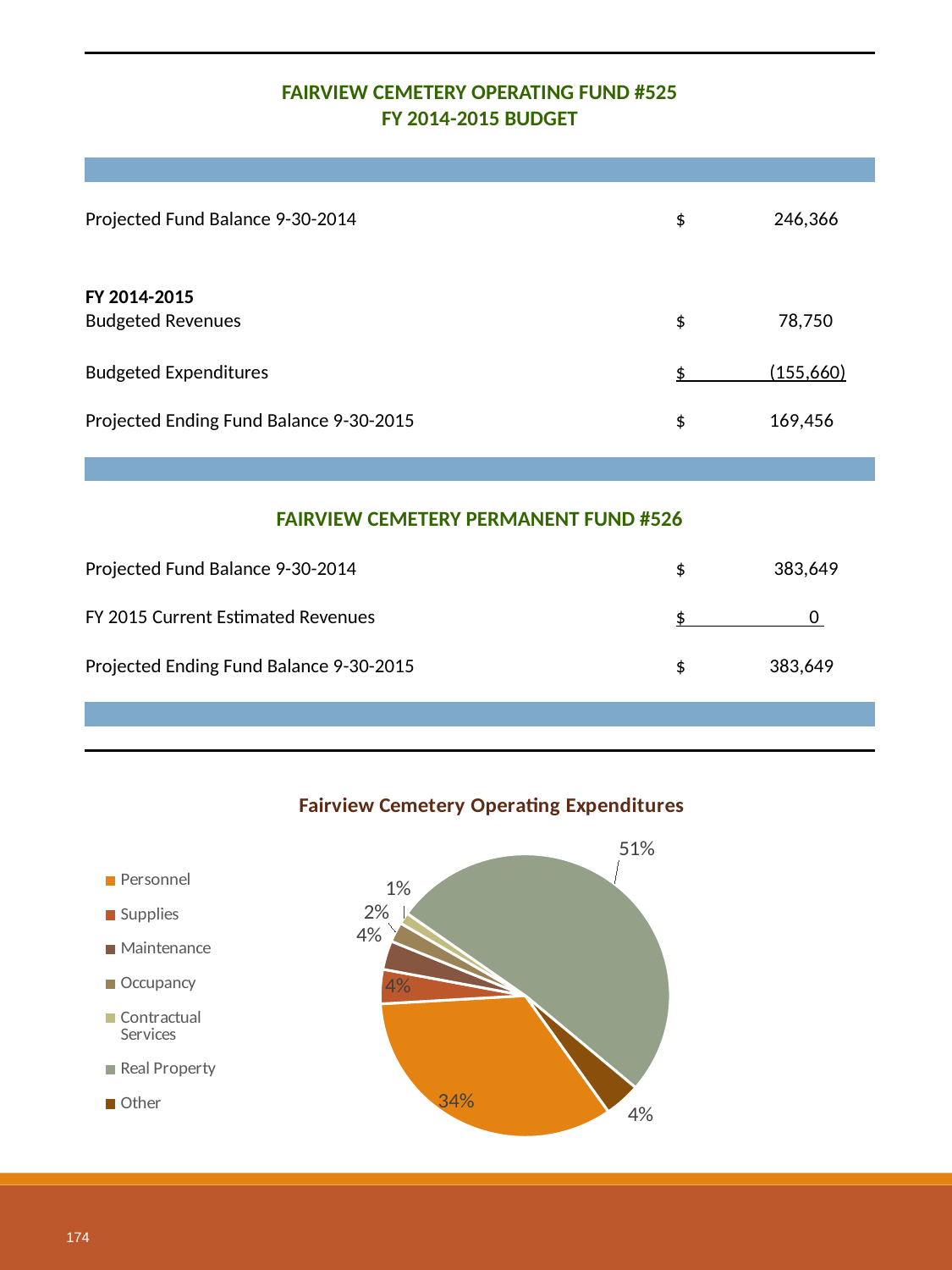
What is the title of the chart on the slide? Fairview Cemetery Operating Expenditures What percentage of the pie chart is Contractual Services? 1% What share of Fairview Cemetery Operating Expenditures is Personnel? 34% By how many percentage points does Real Property exceed Personnel in the pie chart? 17 percentage points What kind of chart is used to show Fairview Cemetery Operating Expenditures? Pie chart What percentage of the pie chart is Occupancy? 2% Which is larger in the pie chart, Personnel or Real Property? Real Property What is the combined share of Real Property and Personnel in the pie chart? 85% Which category has the smallest share of Fairview Cemetery Operating Expenditures? Contractual Services What share of Fairview Cemetery Operating Expenditures is Real Property? 51% How many categories does the pie chart's legend list? 7 Which category has the largest share of Fairview Cemetery Operating Expenditures? Real Property